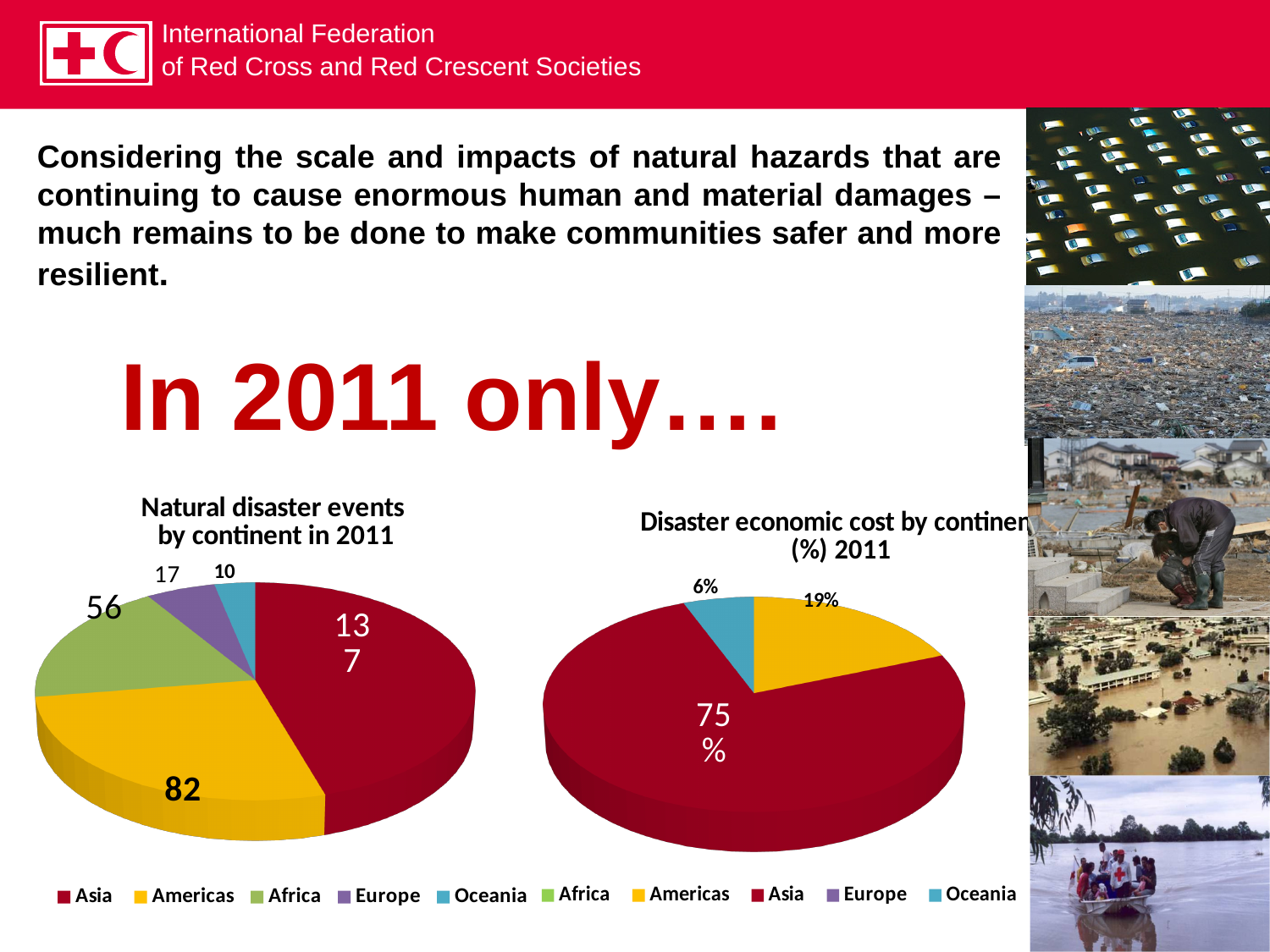
In the 'Disaster economic cost by continent (%) 2011' chart, what share is shown for Asia? 75% In the 'Natural disaster events by continent in 2011' chart, which continent has the most events? Asia What kind of chart is the 'Disaster economic cost by continent (%) 2011' chart? Pie chart In the 'Natural disaster events by continent in 2011' chart, what is the value for Africa? 56 In the 'Disaster economic cost by continent (%) 2011' chart, what share is shown for the Americas? 19% In the 'Disaster economic cost by continent (%) 2011' chart, what share is shown for Oceania? 6% In the 'Natural disaster events by continent in 2011' chart, what is the value for Oceania? 10 In the 'Natural disaster events by continent in 2011' chart, how many events are shown for the Americas? 82 In the 'Natural disaster events by continent in 2011' chart, how many more events does Asia have than the Americas? 55 How many continents does the legend of the 'Natural disaster events by continent in 2011' chart list? 5 In the 'Natural disaster events by continent in 2011' chart, which continent has the fewest events? Oceania In the 'Natural disaster events by continent in 2011' chart, how many events are shown for Asia? 137